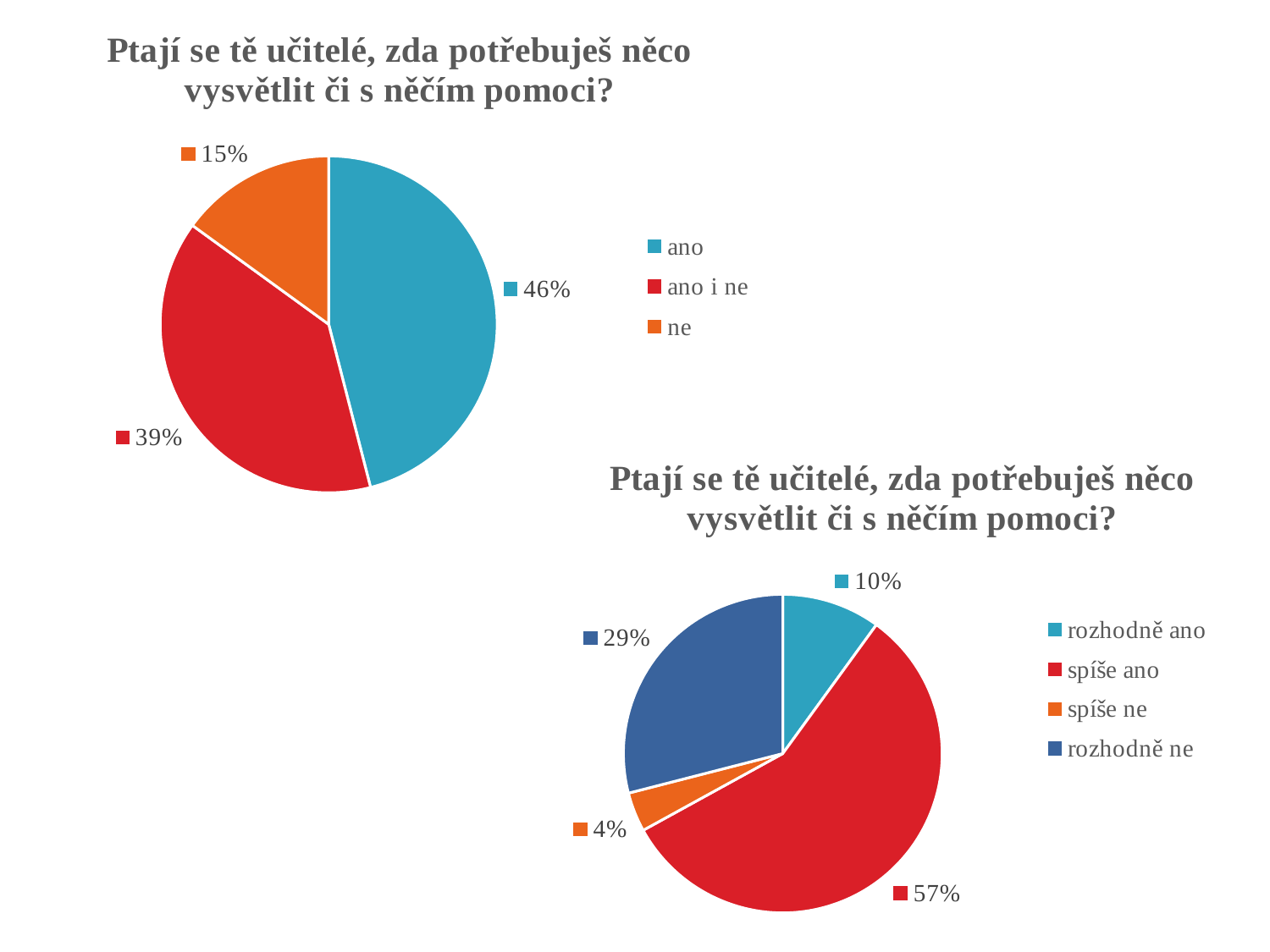
In the bottom-right pie chart, what share of respondents answered "spíše ano"? 57% In the top-left pie chart, what share of respondents answered "ne"? 15% In the bottom-right pie chart, which is larger: "rozhodně ano" or "rozhodně ne"? rozhodně ne In the top-left pie chart, which category has the smallest slice? ne How many categories does the legend of the top-left pie chart list? 3 In the top-left pie chart, what share of respondents answered "ano"? 46% In the top-left pie chart, which category has the largest slice? ano In the bottom-right pie chart, which category has the smallest slice? spíše ne In the bottom-right pie chart, what share of respondents answered "rozhodně ne"? 29% What type of chart is shown in the bottom-right of the slide? pie chart How many categories does the legend of the bottom-right pie chart list? 4 In the top-left pie chart, what is the difference in percentage points between "ano" and "ano i ne"? 7